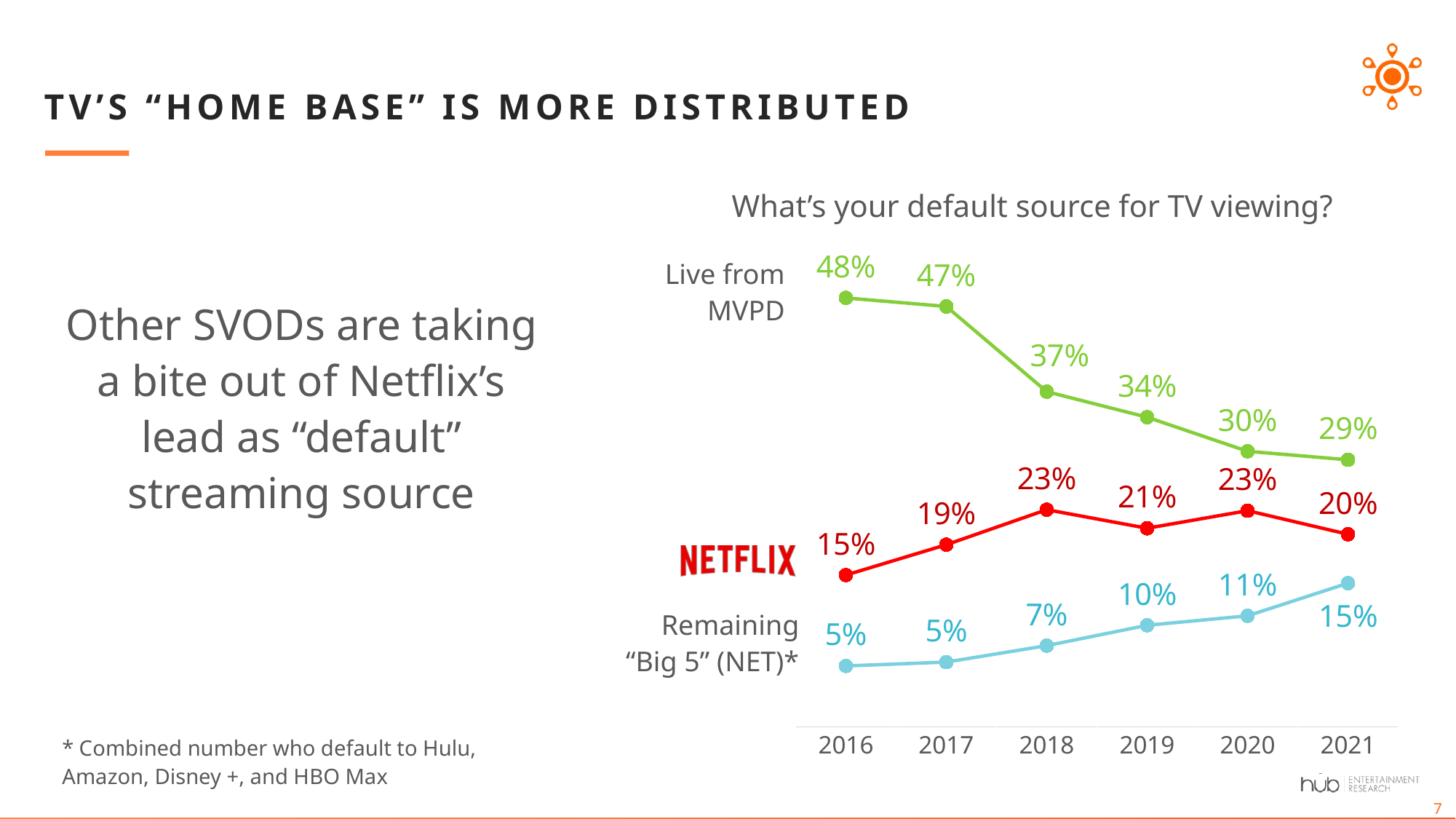
What is the difference between the Live from MVPD values in 2016 and 2021? 19% In which year was the Remaining "Big 5" (NET) value highest? 2021 What kind of chart is shown on the slide? Line chart Which was larger in 2019: Netflix or Remaining "Big 5" (NET)? Netflix How many years are shown on the x axis? 6 What was the value for Remaining "Big 5" (NET) in 2021? 15% What is the difference between the Netflix and Remaining "Big 5" (NET) values in 2021? 5% What was the value for Live from MVPD in 2016? 48% Does the Live from MVPD line rise or fall from 2016 to 2021? Fall How many series are plotted on the chart? 3 What was the value for Netflix in 2018? 23% In which year was the Live from MVPD value lowest? 2021